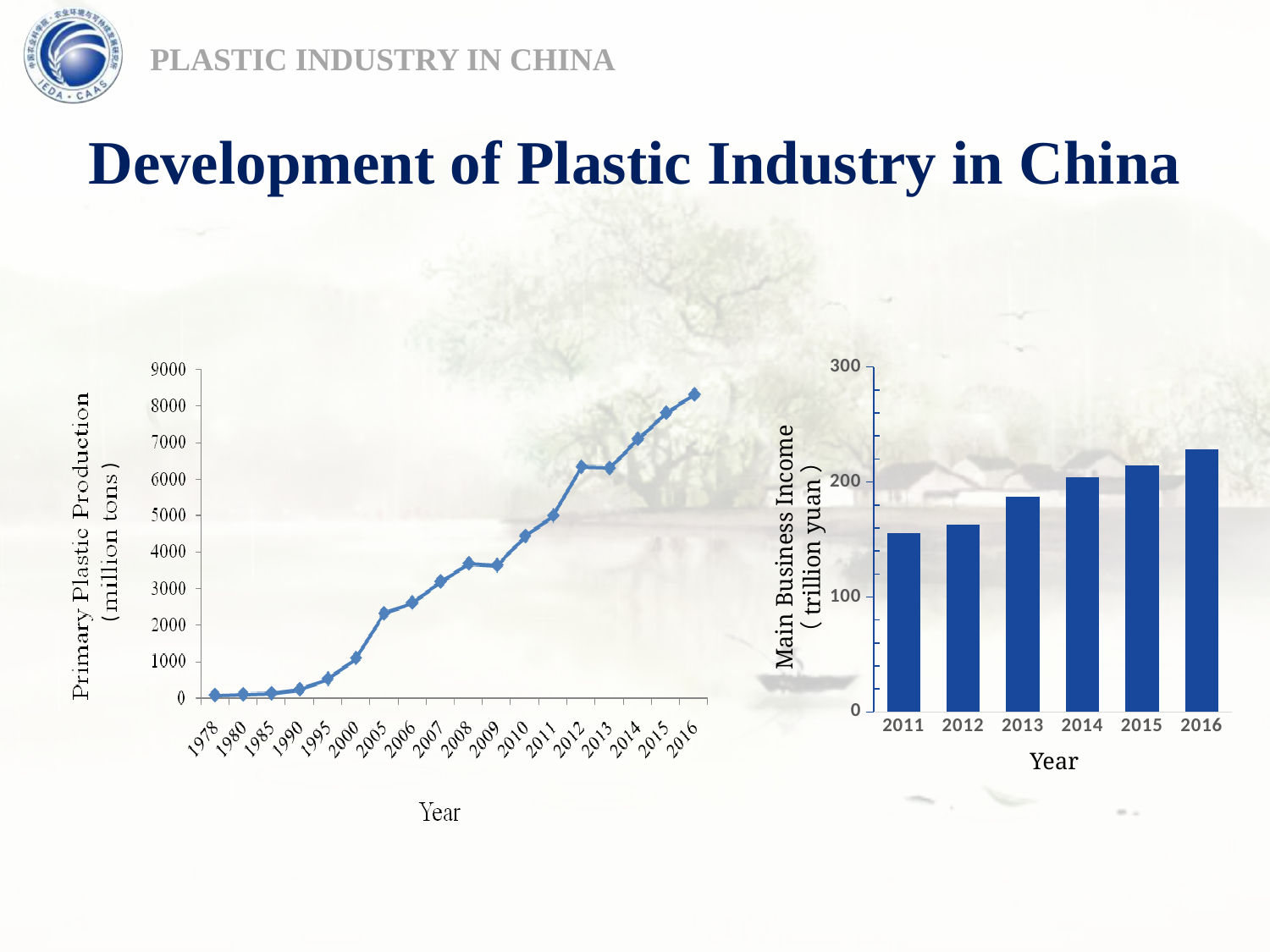
In the left chart (Primary Plastic Production), which is larger, the value for 2005 or the value for 2015? 2015 What kind of chart is the right chart showing Main Business Income? bar chart In the left chart (Primary Plastic Production), is the value for 2010 greater or less than 5000? less In the left chart (Primary Plastic Production), how many data points are plotted on the line? 18 In the left chart (Primary Plastic Production), is the value for 2016 greater or less than 8000? greater In the right chart (Main Business Income), is the value for 2011 greater or less than 200? less In the left chart (Primary Plastic Production), do the values generally rise or fall from 1978 to 2016? rise In the right chart (Main Business Income), which year has the highest value? 2016 In the right chart (Main Business Income), which year has the lowest value? 2011 In the right chart (Main Business Income), how many years are shown on the x axis? 6 What kind of chart is the left chart showing Primary Plastic Production? line chart